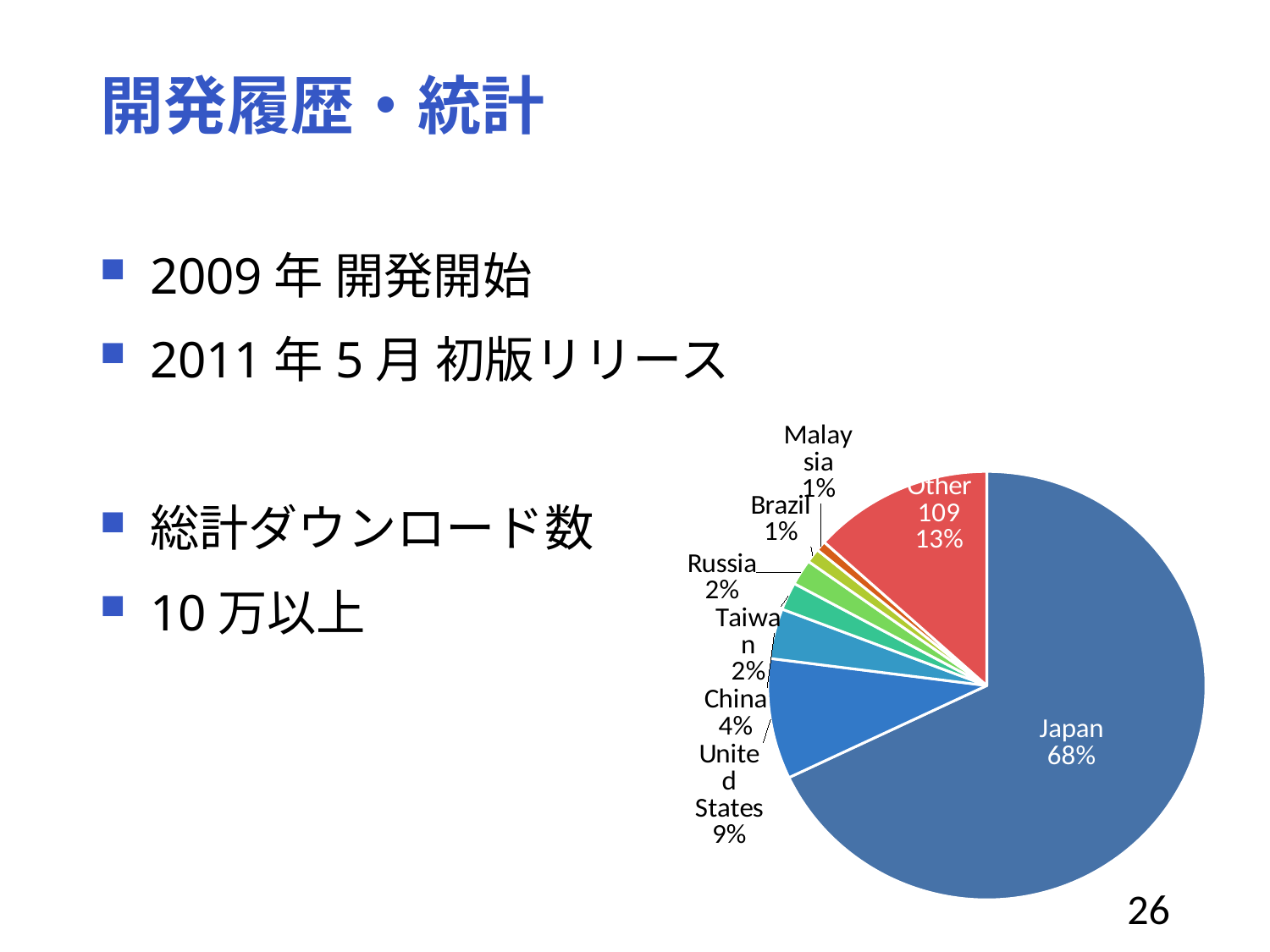
What value is printed on the Other slice besides its percentage? 109 What percentage is shown for Russia? 2% Which is larger, the share for the United States or the share for China? United States Which slice of the pie is the largest? Japan What share of the pie does Japan account for? 68% What percentage is shown for China? 4% What is the difference in percentage points between Japan's share and the Other share? 55 What percentage is shown for the Other slice? 13% What colour is the Japan slice? blue What percentage is shown for the United States slice? 9% How many slices does the pie chart have? 8 What kind of chart is shown on the slide? pie chart